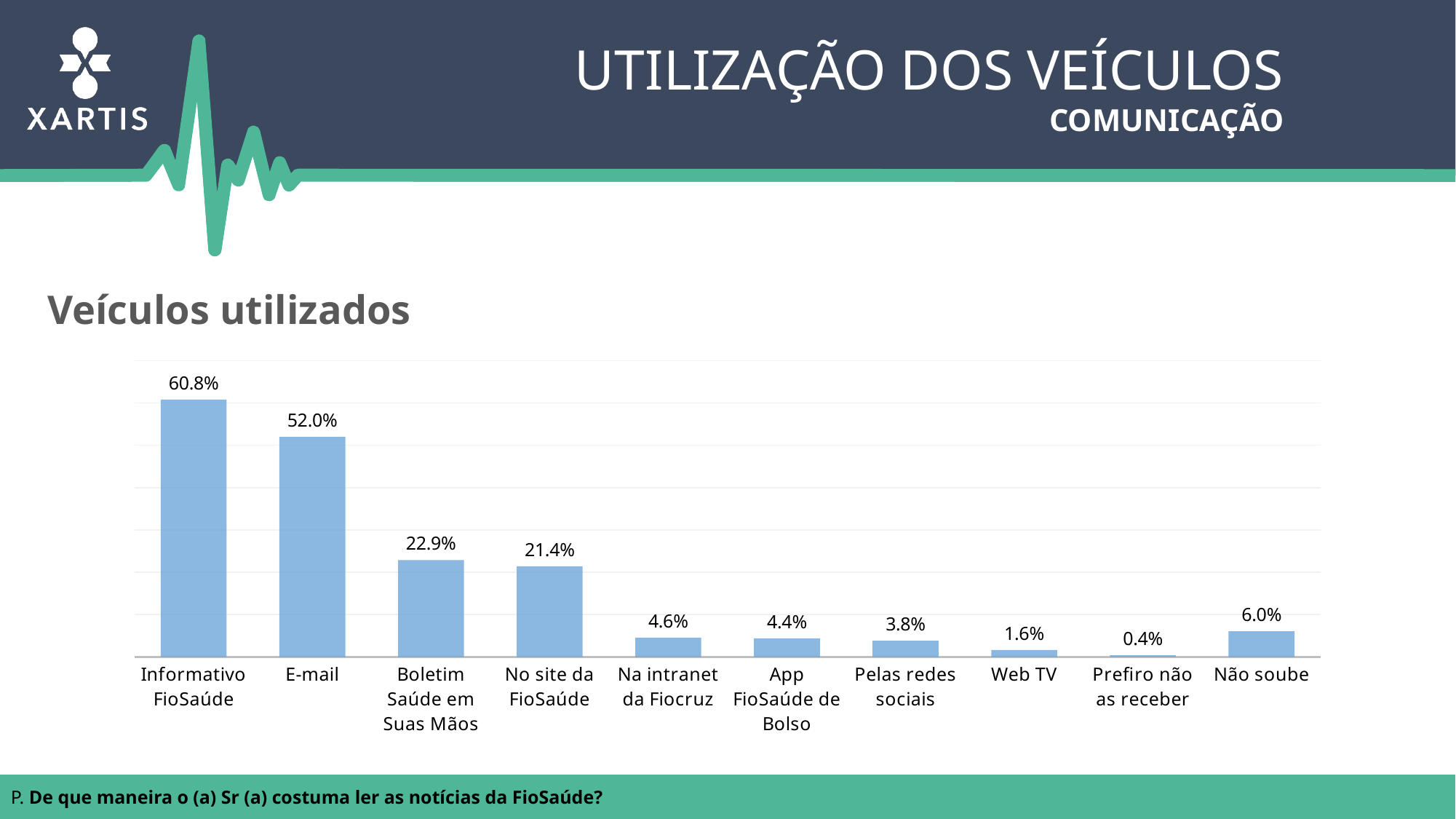
What is the value for Informativo FioSaúde? 60.8% What kind of chart is shown on the slide? Bar chart What is the difference between Informativo FioSaúde and E-mail? 8.8% Which is larger, Na intranet da Fiocruz or Pelas redes sociais? Na intranet da Fiocruz What is the difference between Boletim Saúde em Suas Mãos and No site da FioSaúde? 1.5% Which category has the lowest value? Prefiro não as receber What is the value for Web TV? 1.6% What is the value for E-mail? 52.0% What is the value for Não soube? 6.0% Which category has the highest value? Informativo FioSaúde What is the title of the chart? Veículos utilizados How many categories are shown in the chart? 10